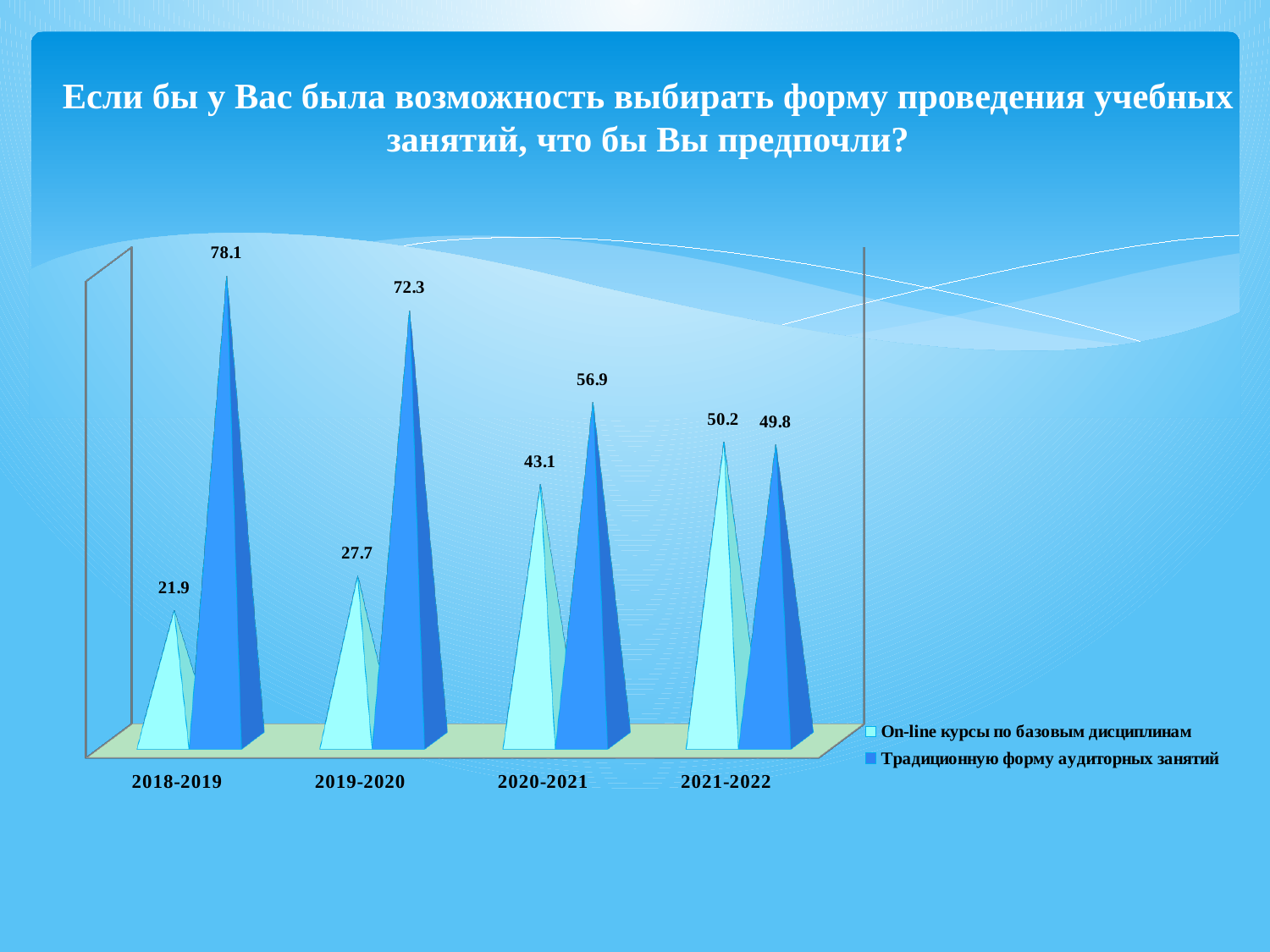
What is the difference between Традиционную форму аудиторных занятий and On-line курсы по базовым дисциплинам in 2020-2021? 13.8 What kind of chart is shown on the slide? Bar chart How many years (categories) are shown on the x axis? 4 Which colour represents Традиционную форму аудиторных занятий in the legend? Blue What is the value for On-line курсы по базовым дисциплинам in 2018-2019? 21.9 In which year is the value for On-line курсы по базовым дисциплинам the lowest? 2018-2019 Which is larger in 2019-2020: On-line курсы по базовым дисциплинам or Традиционную форму аудиторных занятий? Традиционную форму аудиторных занятий Does the value for On-line курсы по базовым дисциплинам rise or fall from 2018-2019 to 2021-2022? Rise How many series does the legend list? 2 What is the value for On-line курсы по базовым дисциплинам in 2021-2022? 50.2 In which year is the value for Традиционную форму аудиторных занятий the highest? 2018-2019 What is the value for Традиционную форму аудиторных занятий in 2019-2020? 72.3